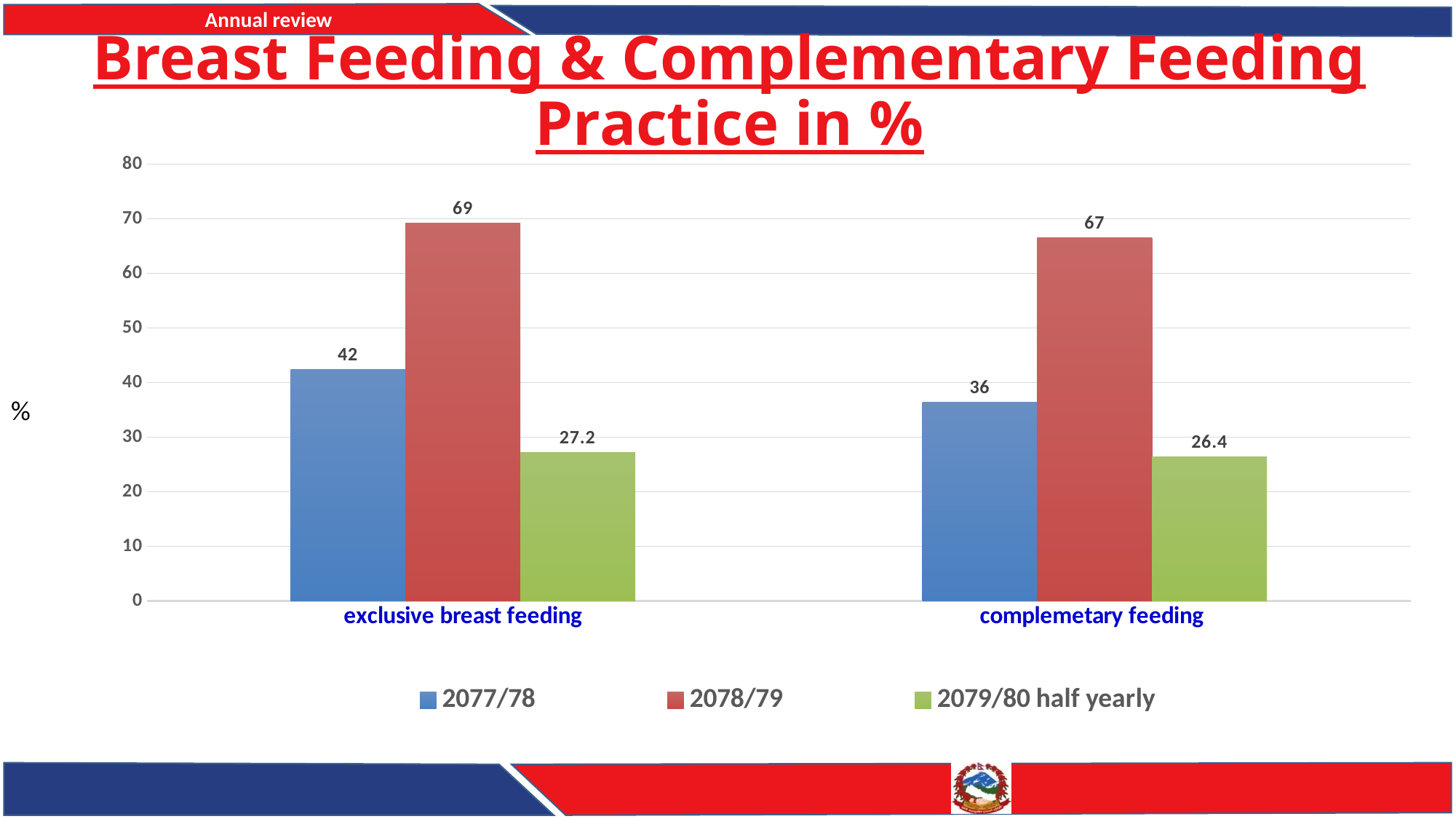
What is the value for 2078/79 in the exclusive breast feeding category? 69 What colour are the bars for the 2079/80 half yearly series? green What is the value for 2079/80 half yearly in the complemetary feeding category? 26.4 How many categories are shown on the x axis? 2 How many series does the legend list? 3 Is the 2079/80 half yearly value for exclusive breast feeding greater or less than 30? less What kind of chart is shown on the slide? bar chart Which series has the lowest value in the complemetary feeding category? 2079/80 half yearly Which series has the highest value in the exclusive breast feeding category? 2078/79 What is the value for 2077/78 in the complemetary feeding category? 36 What is the difference between the 2078/79 and 2077/78 values for exclusive breast feeding? 27 Which is larger: the 2077/78 value for exclusive breast feeding or the 2077/78 value for complemetary feeding? exclusive breast feeding